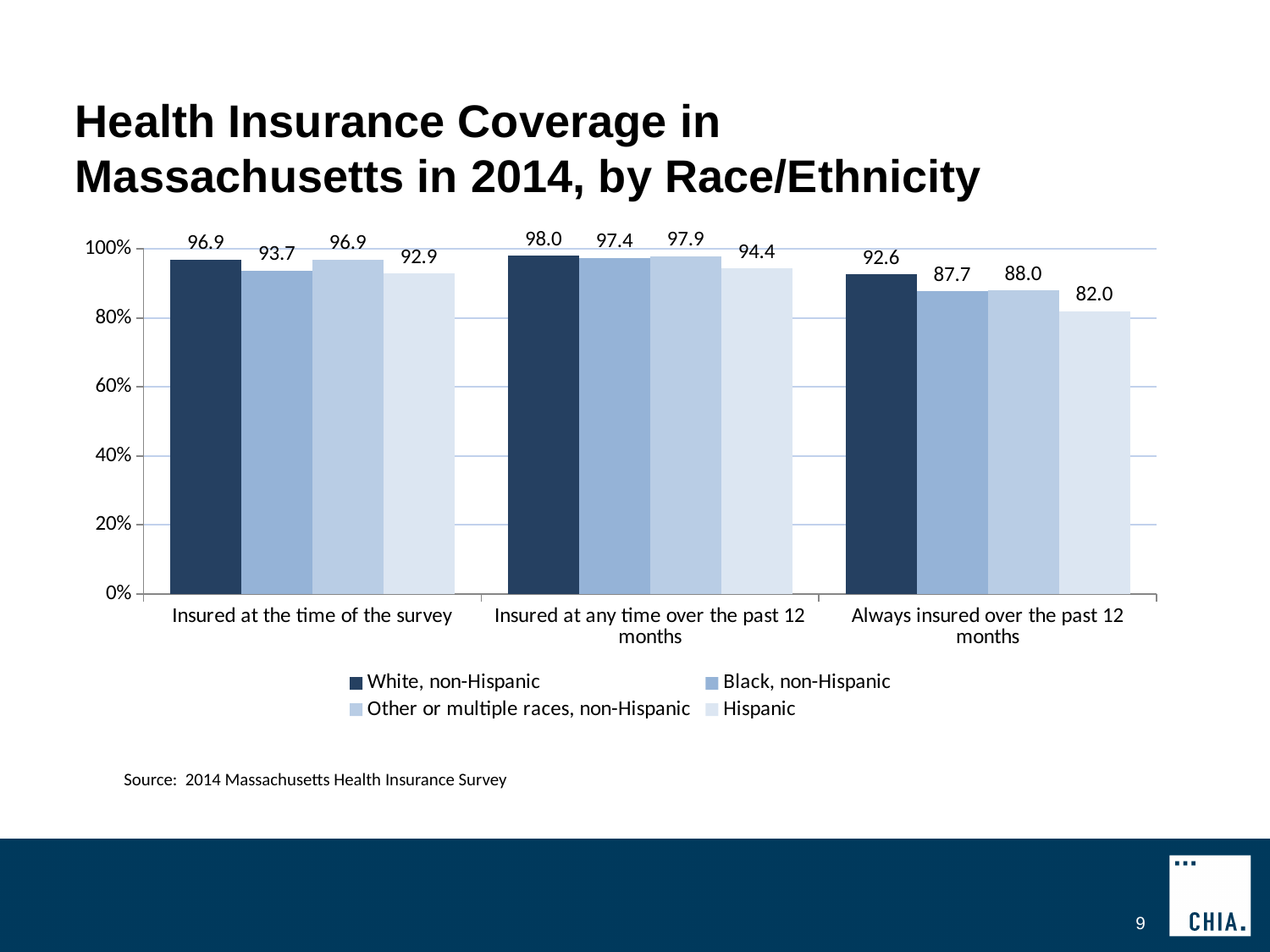
What is the value for Hispanic in the 'Always insured over the past 12 months' category? 82.0 Is the value for Hispanic in the 'Always insured over the past 12 months' category greater or less than 80%? greater What is the value for Black, non-Hispanic in the 'Insured at any time over the past 12 months' category? 97.4 What kind of chart is shown on the slide? Bar chart Which race/ethnicity group has the lowest value in the 'Always insured over the past 12 months' category? Hispanic In the 'Always insured over the past 12 months' category, which is larger: the value for Black, non-Hispanic or the value for Hispanic? Black, non-Hispanic What is the value for White, non-Hispanic in the 'Insured at the time of the survey' category? 96.9 How many series does the legend list? 4 How many categories are shown on the x axis? 3 Which race/ethnicity group has the highest value in the 'Insured at any time over the past 12 months' category? White, non-Hispanic What is the difference between the White, non-Hispanic and Hispanic values in the 'Always insured over the past 12 months' category? 10.6 What is the difference between the Black, non-Hispanic and Hispanic values in the 'Insured at the time of the survey' category? 0.8